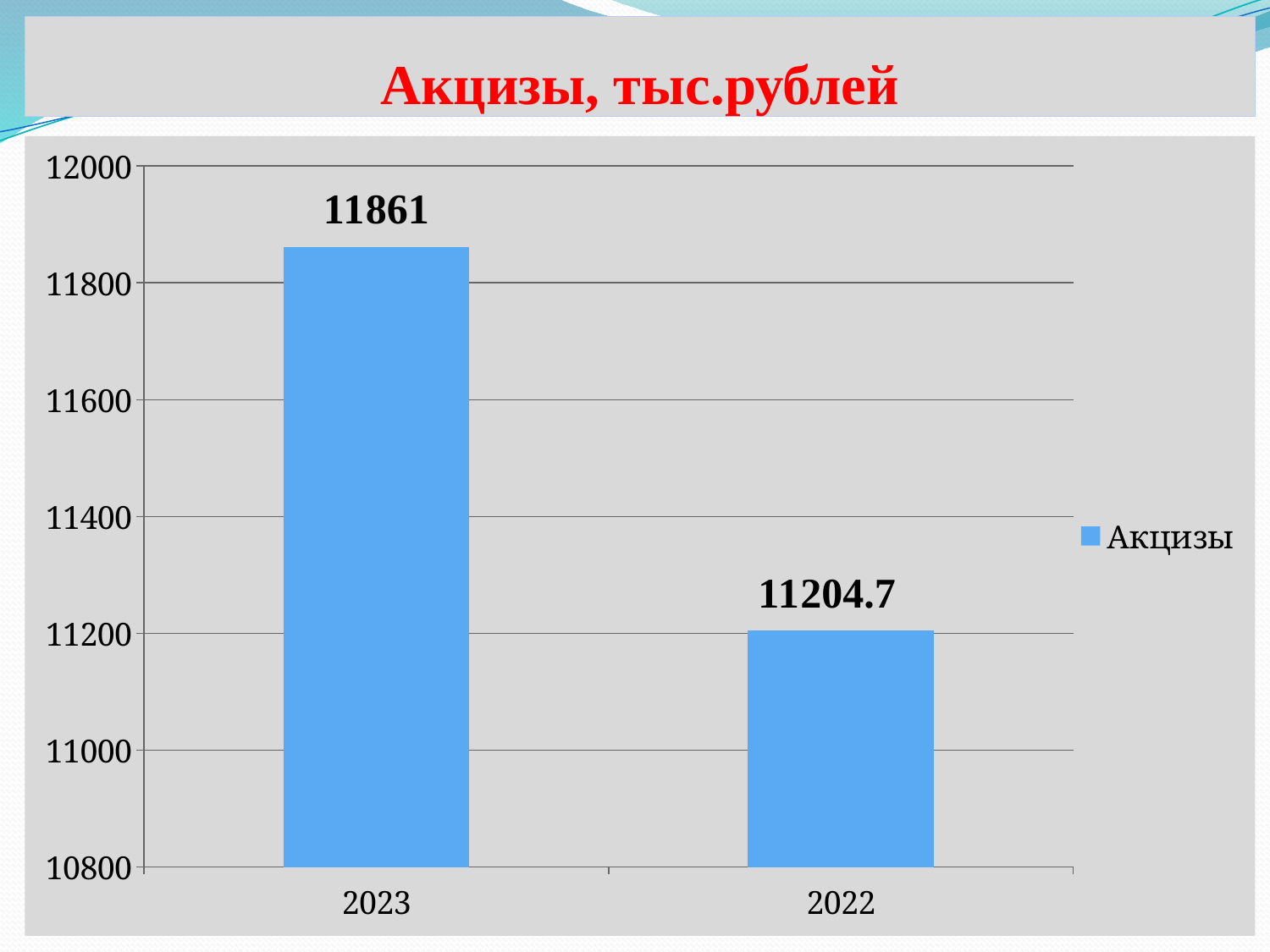
Which year has the lowest value? 2022 Which year has the highest value? 2023 What kind of chart is shown on the slide? bar chart Is the value for 2022 greater or less than 11400? less How many series does the legend list? 1 What is the value for 2022? 11204.7 What is the difference between the values for 2023 and 2022? 656.3 How many categories are shown on the x axis? 2 What is the value for 2023? 11861 Is the value for 2023 greater or less than 11800? greater Which is larger, the value for 2023 or the value for 2022? 2023 What is the title of the chart? Акцизы, тыс.рублей